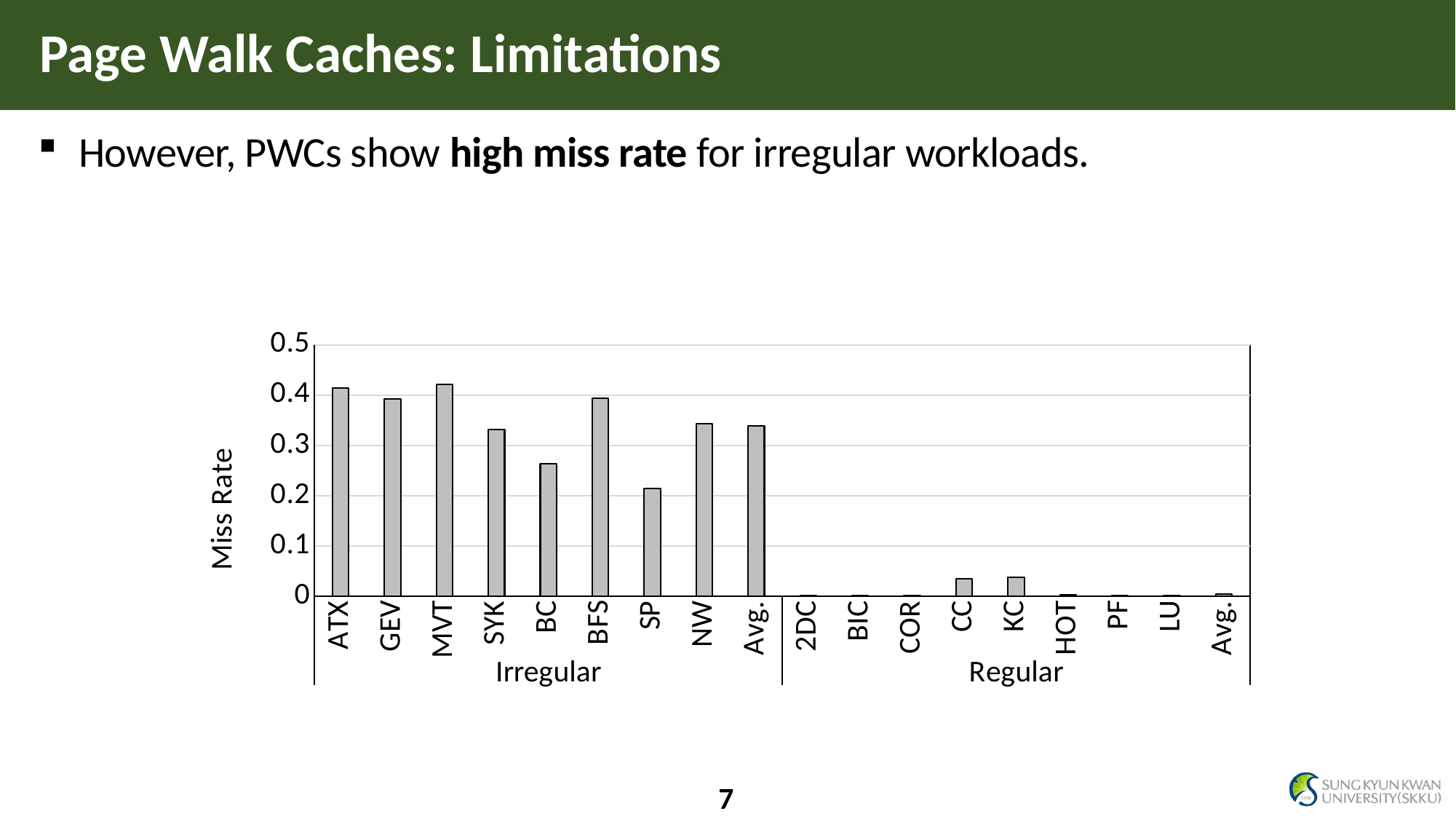
Is the miss rate for SYK greater or less than 0.3? greater Which category in the Irregular group has the lowest miss rate? SP What is the label of the y axis? Miss Rate What kind of chart is shown on the slide? bar chart What are the two workload groups labelled on the x axis? Irregular and Regular Is the miss rate for ATX greater or less than 0.4? greater Is the miss rate for CC greater or less than 0.1? less Which has the higher miss rate, BC or BFS? BFS How many categories are in the Irregular group? 9 Which has the higher miss rate, the Irregular Avg. or the Regular Avg.? Irregular Avg. How many workload categories are plotted on the x axis in total? 18